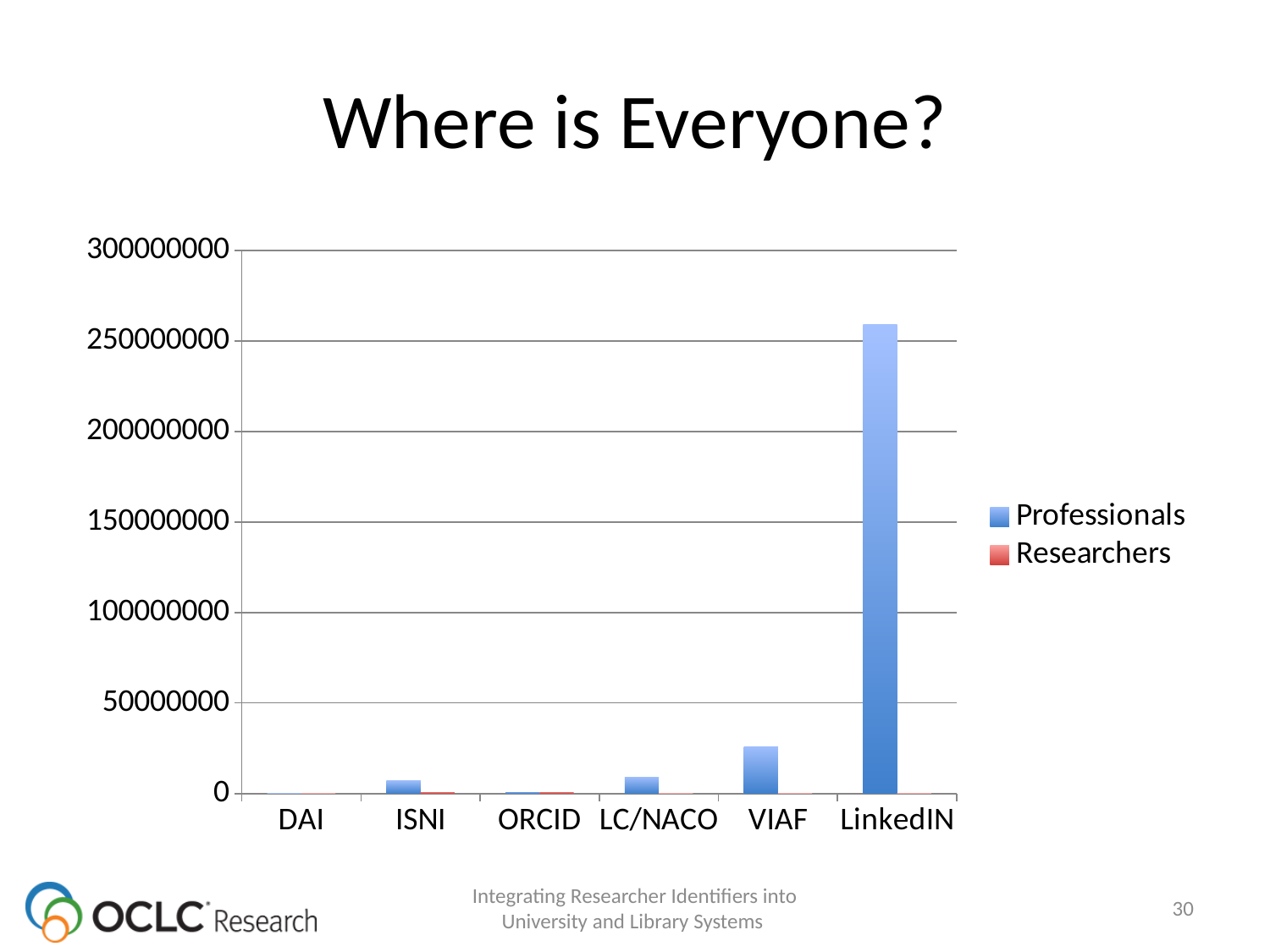
Which has a larger Professionals value, VIAF or LinkedIN? LinkedIN What is the title of the chart? Where is Everyone? How many series does the legend list? 2 Which series is shown in blue in the chart? Professionals Is the Professionals value for VIAF greater or less than 50000000? less Is the Professionals value for LC/NACO greater or less than 50000000? less Which has a larger Professionals value, VIAF or ISNI? VIAF What kind of chart is shown on the slide? bar chart How many categories are shown on the x axis of the chart? 6 Which category has the highest Professionals value? LinkedIN Is the Professionals value for LinkedIN greater or less than 250000000? greater